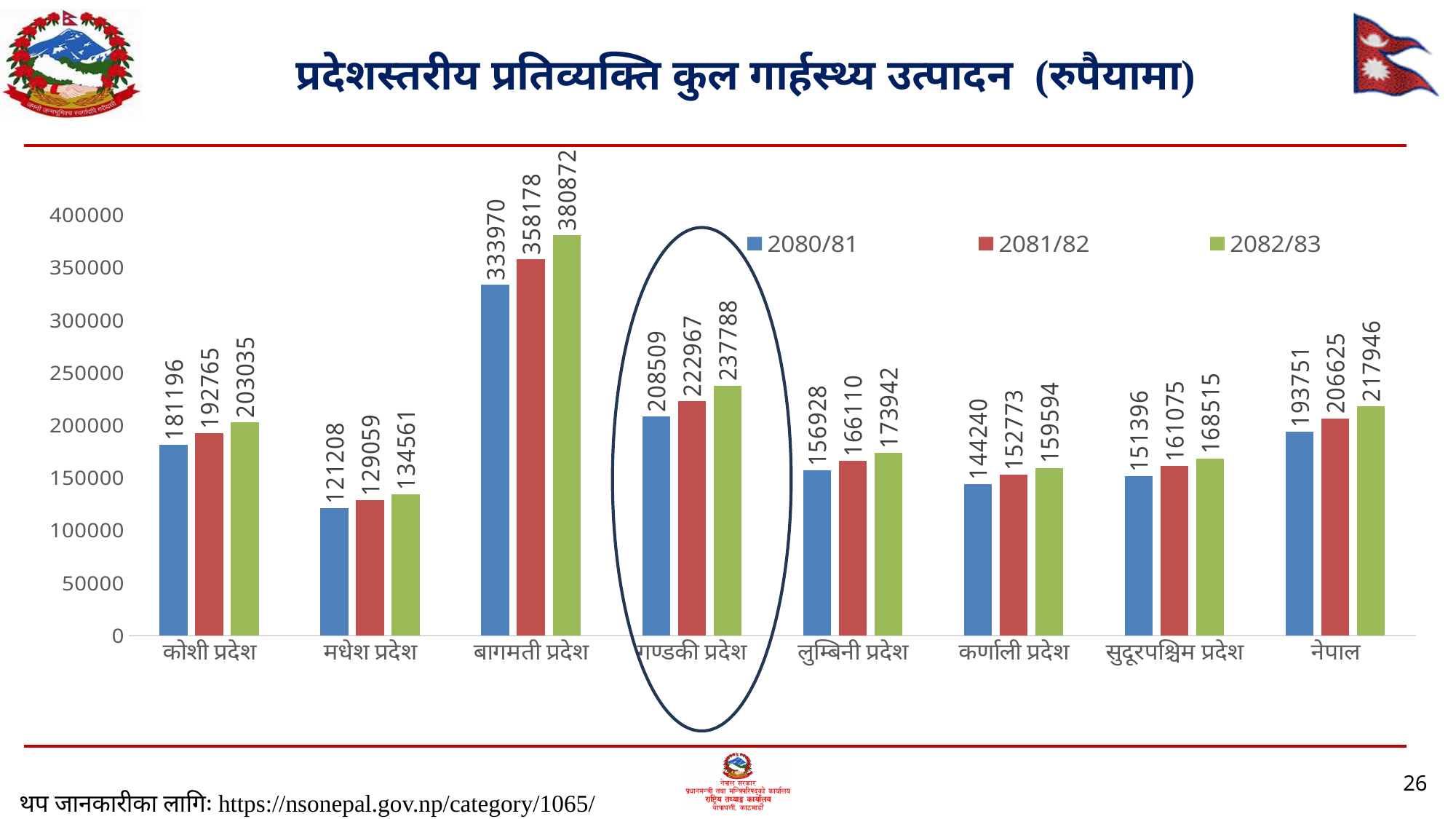
Which category on the chart is circled? गण्डकी प्रदेश What is the difference between the 2082/83 and 2080/81 values for कोशी प्रदेश? 21839 Which category has the lowest value in 2080/81? मधेश प्रदेश What is the value for गण्डकी प्रदेश in 2080/81? 208509 What type of chart is shown on the slide? bar chart What is the value for बागमती प्रदेश in 2082/83? 380872 Which is larger: the 2082/83 value for कर्णाली प्रदेश or the 2082/83 value for सुदूरपश्चिम प्रदेश? सुदूरपश्चिम प्रदेश What is the value for नेपाल in 2081/82? 206625 Do the values for लुम्बिनी प्रदेश rise or fall from 2080/81 to 2082/83? rise How many categories are shown on the x axis? 8 How many series does the legend list? 3 Which category has the highest value in 2082/83? बागमती प्रदेश